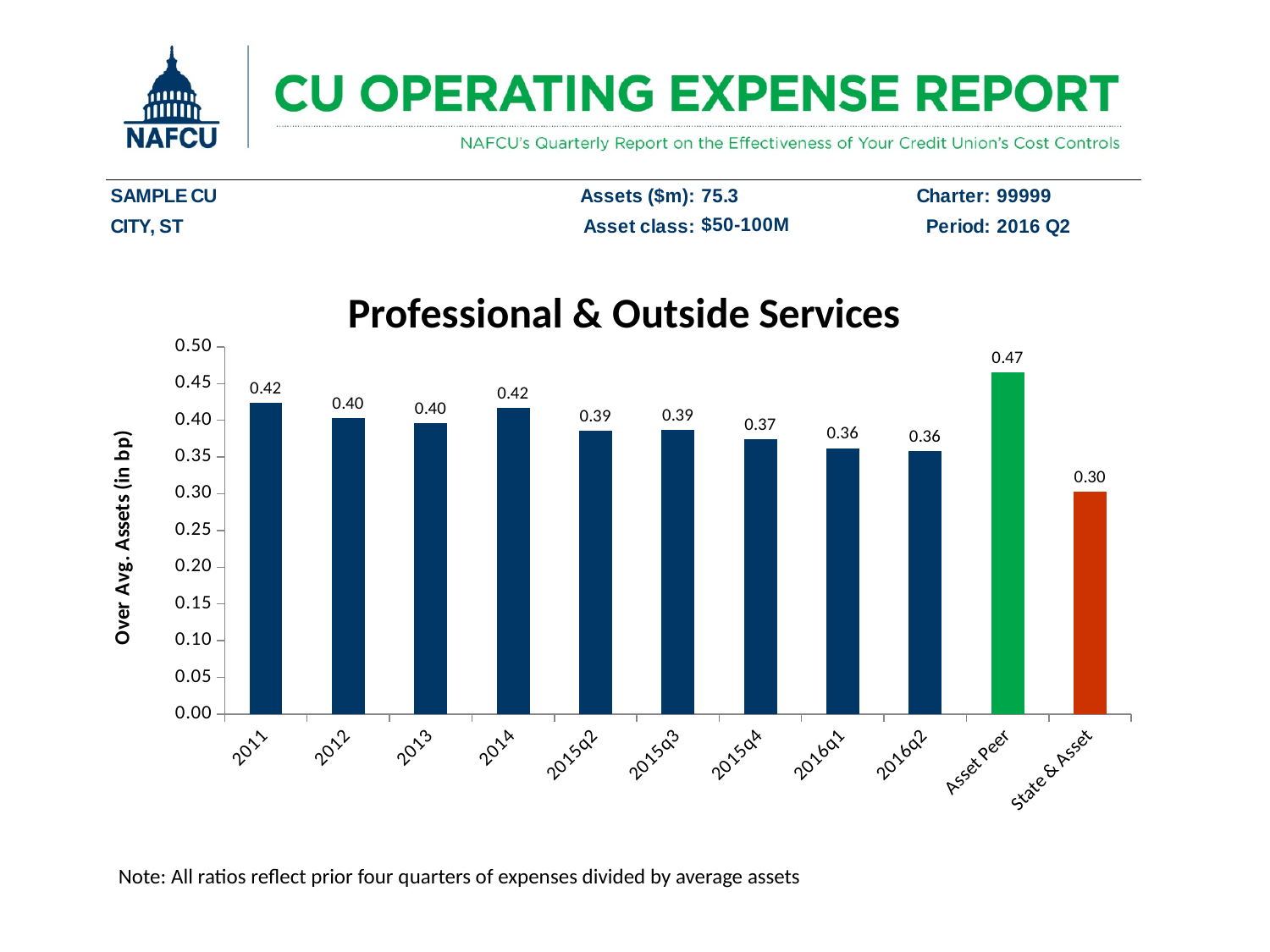
Is the value for 2016q1 greater or less than 0.40? less Do the values generally rise or fall from 2011 to 2016q2? Fall What is the value for Asset Peer? 0.47 Which category has the highest value? Asset Peer Which category has the lowest value? State & Asset How many bars are shown in the chart? 11 What is the difference between the 2011 value and the 2016q2 value? 0.06 Which is larger, the value for 2014 or the value for 2015q4? 2014 What is the difference between the Asset Peer value and the State & Asset value? 0.17 What is the value for 2016q2? 0.36 What is the value for 2011 in the Professional & Outside Services chart? 0.42 What kind of chart is shown on the slide? Bar chart